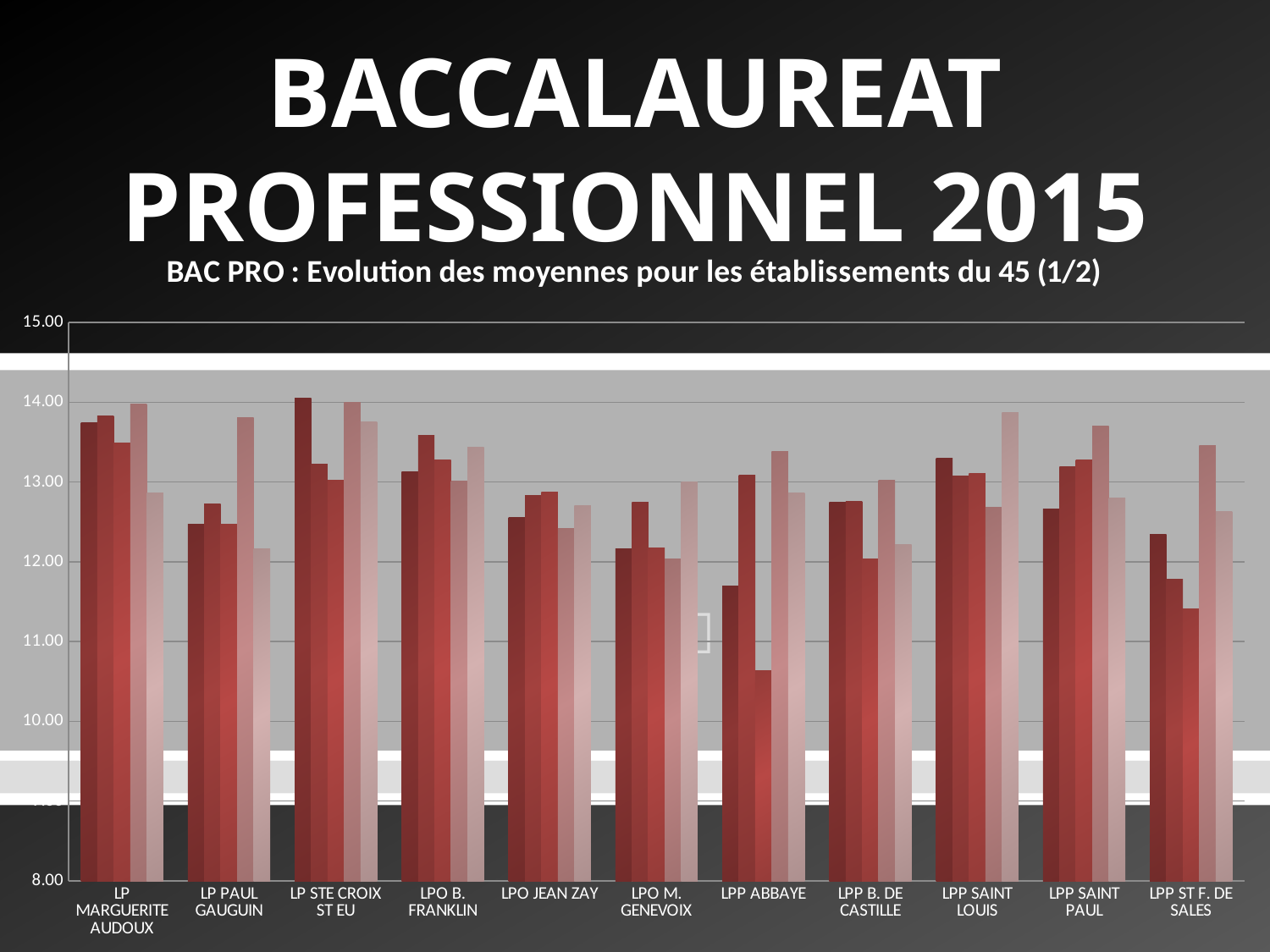
Is the first bar for LPP SAINT LOUIS greater or less than 13.00? greater How many establishments are shown on the x axis of the chart? 11 Is the lowest bar for LPP ST F. DE SALES greater or less than 12.00? less Is the lowest bar for LPP ABBAYE greater or less than 11.00? less What is the highest value shown on the y axis of the chart? 15.00 What kind of chart is shown on the slide? bar chart What is the title of the chart? BAC PRO : Evolution des moyennes pour les établissements du 45 (1/2) Which is larger: the first bar for LP MARGUERITE AUDOUX or the first bar for LP PAUL GAUGUIN? LP MARGUERITE AUDOUX How many bars are plotted for each establishment? 5 Which establishment has the lowest bar in the chart? LPP ABBAYE